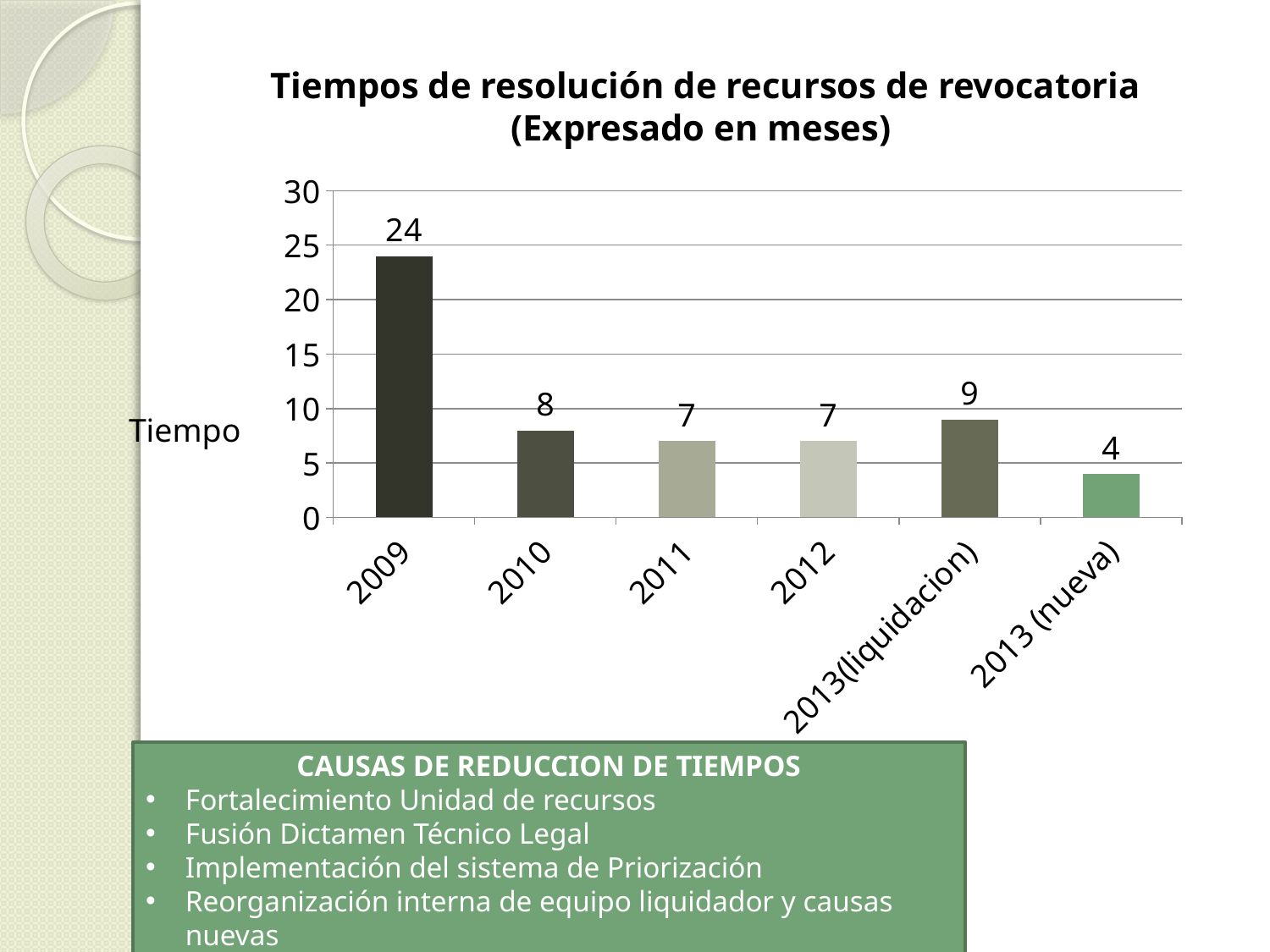
Which is larger, the value for 2010 or the value for 2013(liquidacion)? 2013(liquidacion) How many categories are shown on the x axis? 6 What kind of chart is this? bar chart What is the value for 2013 (nueva)? 4 What is the value for 2013(liquidacion)? 9 Which category has the highest value? 2009 Do the values rise or fall from 2009 to 2010? fall Is the value for 2009 greater or less than 20? greater What is the difference between the values for 2009 and 2010? 16 What is the title of the chart? Tiempos de resolución de recursos de revocatoria (Expresado en meses) What is the value for 2009? 24 Which category has the lowest value? 2013 (nueva)